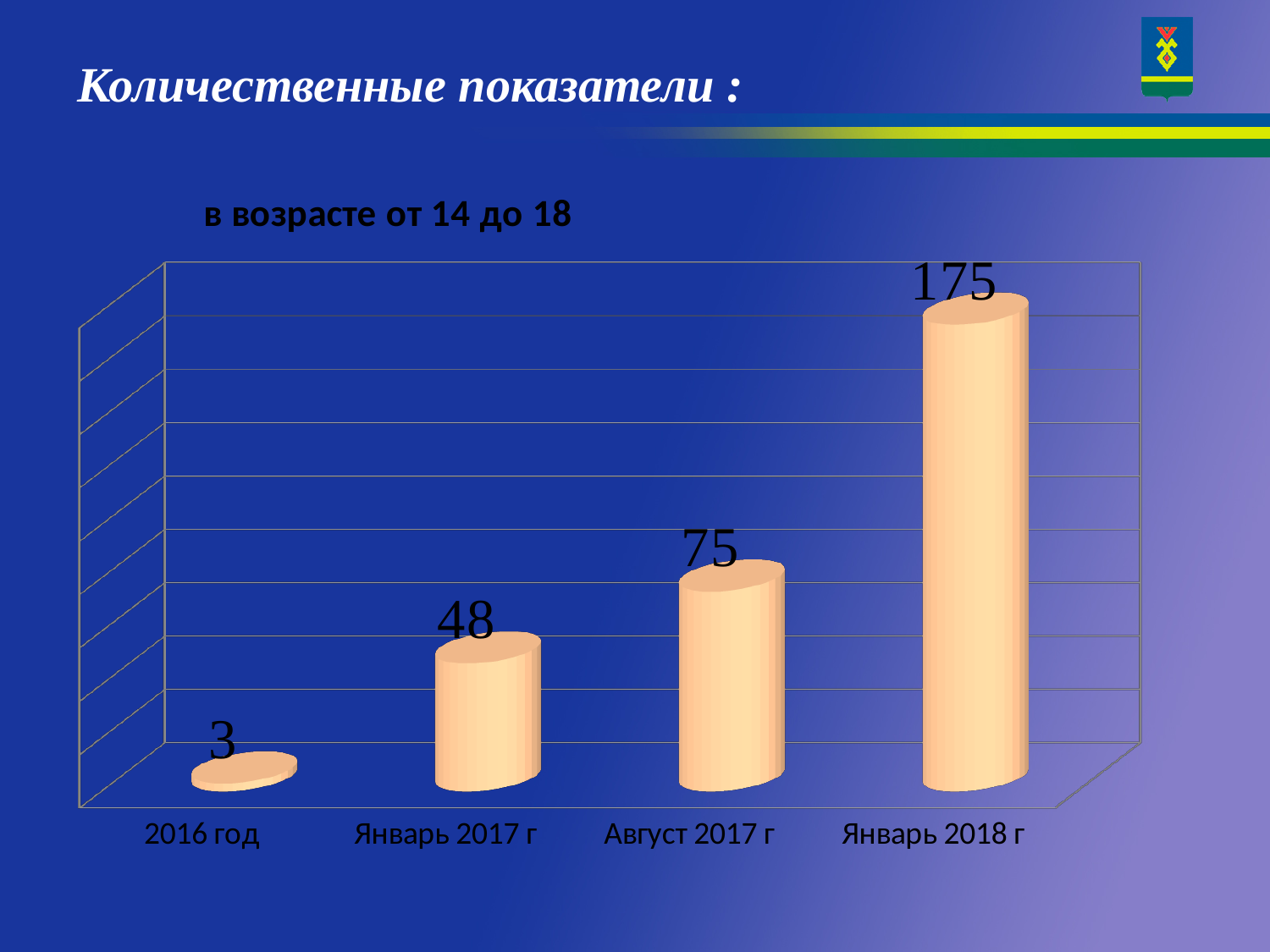
Which category has the highest value? Январь 2018 г What is the difference between the values for Январь 2017 г and 2016 год? 45 Which is larger, the value for Август 2017 г or the value for Январь 2017 г? Август 2017 г What is the value for 2016 год? 3 What is the value for Январь 2018 г? 175 What is the value for Январь 2017 г? 48 What is the difference between the values for Январь 2018 г and Август 2017 г? 100 Which category has the lowest value? 2016 год Do the values rise or fall from left to right along the x axis? rise What is the value for Август 2017 г? 75 What kind of chart is this? bar chart How many categories are shown on the x axis? 4